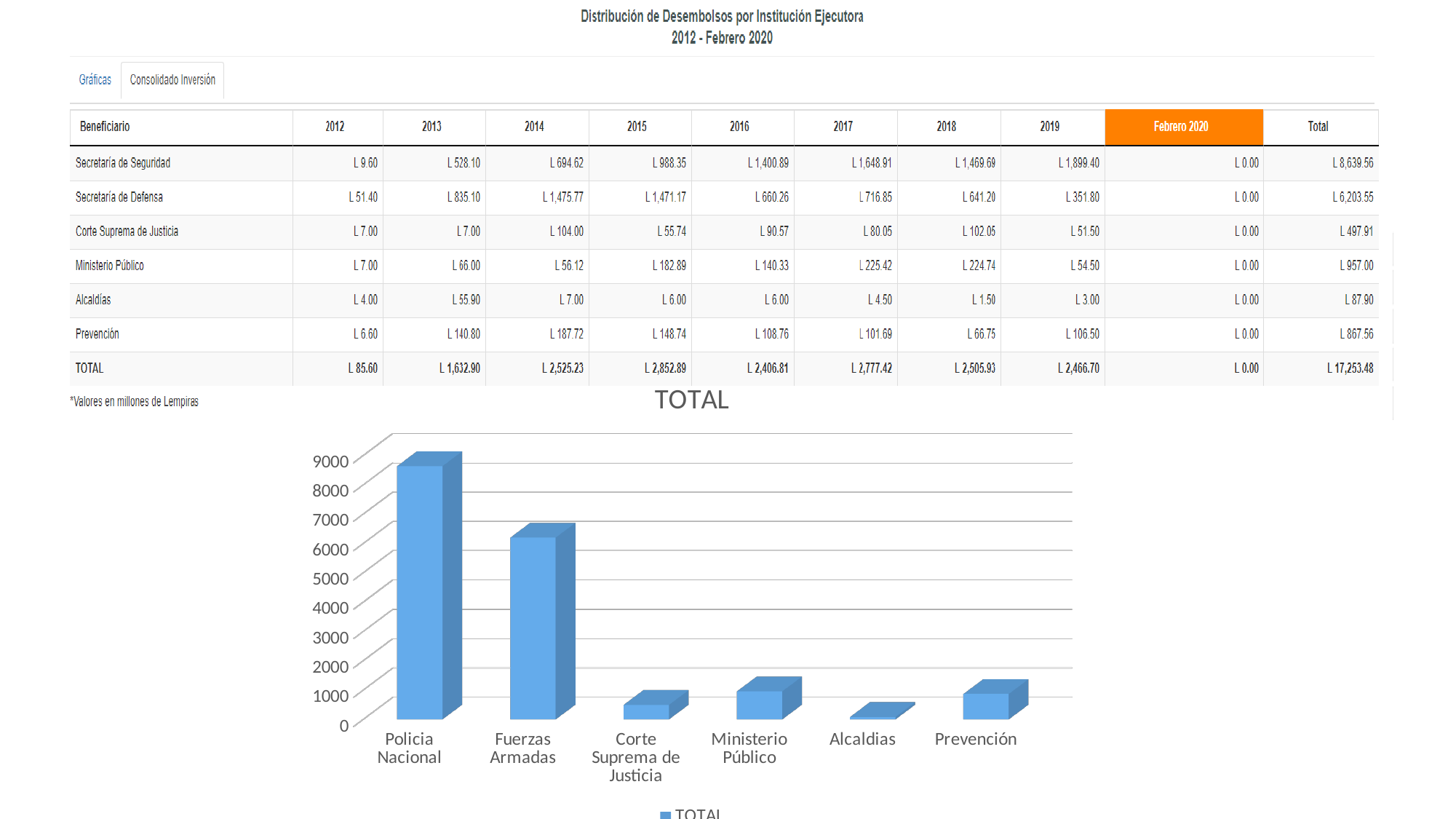
Which is larger, the value for Fuerzas Armadas or the value for Ministerio Público? Fuerzas Armadas What kind of chart is shown on the slide? bar chart How many categories are plotted on the x axis of the chart? 6 Is the value for Ministerio Público greater or less than 2000? less Which is larger, the value for Prevención or the value for Corte Suprema de Justicia? Prevención Is the value for Fuerzas Armadas greater or less than 7000? less Is the value for Policia Nacional greater or less than 8000? greater Which category has the lowest bar in the chart? Alcaldias How many series does the chart legend list? 1 Which category has the highest bar in the chart? Policia Nacional What is the title of the chart? TOTAL